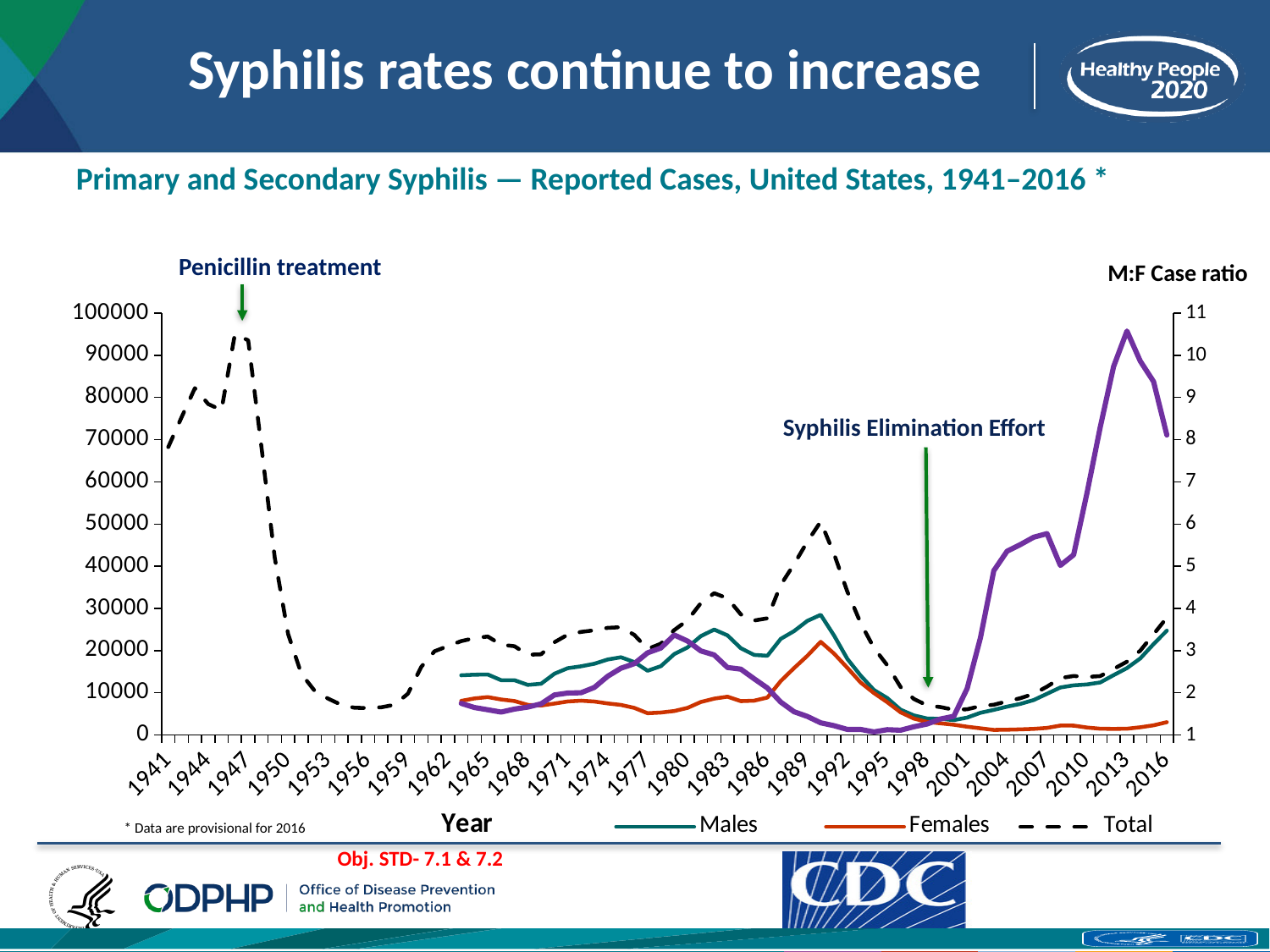
What is the label of the right-hand vertical axis? M:F Case ratio Does the Total line rise or fall between 1947 and 1956? fall Is the Total value for 1990 greater or less than 40000? greater Is the Males value for 2016 greater or less than 20000? greater Is the Total value for 1956 greater or less than 10000? less How many series does the chart legend list? 3 What kind of chart is shown on the slide? line chart In 2016, which is larger, the Males value or the Females value? Males Does the Males line rise or fall between 2001 and 2016? rise